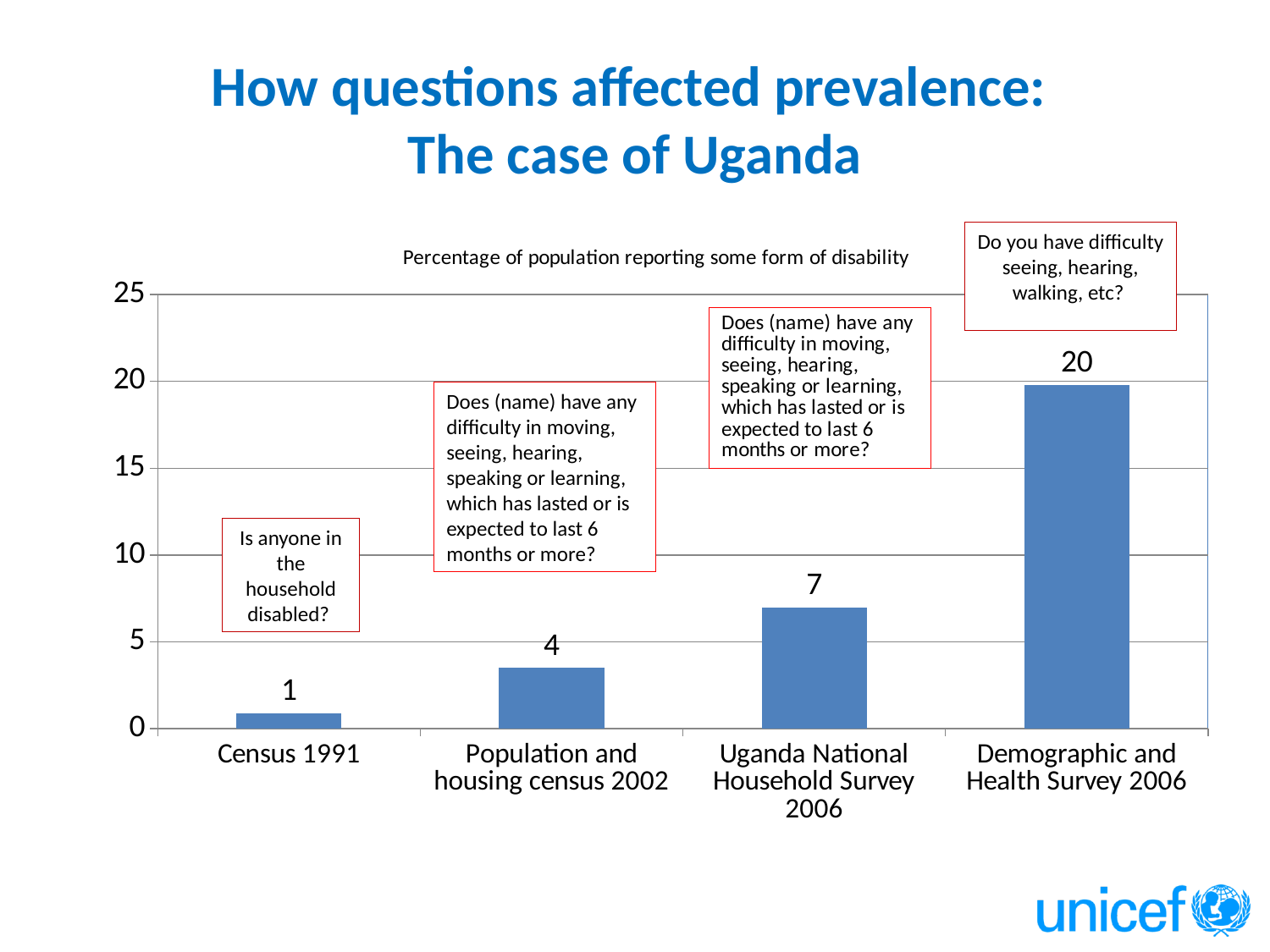
What is the value for Demographic and Health Survey 2006? 20 Do the values rise or fall from left to right along the x axis? Rise How many categories are shown on the x axis? 4 What is the value for Population and housing census 2002? 4 What is the difference between the values for Demographic and Health Survey 2006 and Uganda National Household Survey 2006? 13 What is the title of the chart? Percentage of population reporting some form of disability Which category has the lowest value? Census 1991 What is the value for Census 1991? 1 Which is larger, the value for Population and housing census 2002 or the value for Uganda National Household Survey 2006? Uganda National Household Survey 2006 What kind of chart is shown on the slide? Bar chart Which category has the highest value? Demographic and Health Survey 2006 What is the value for Uganda National Household Survey 2006? 7